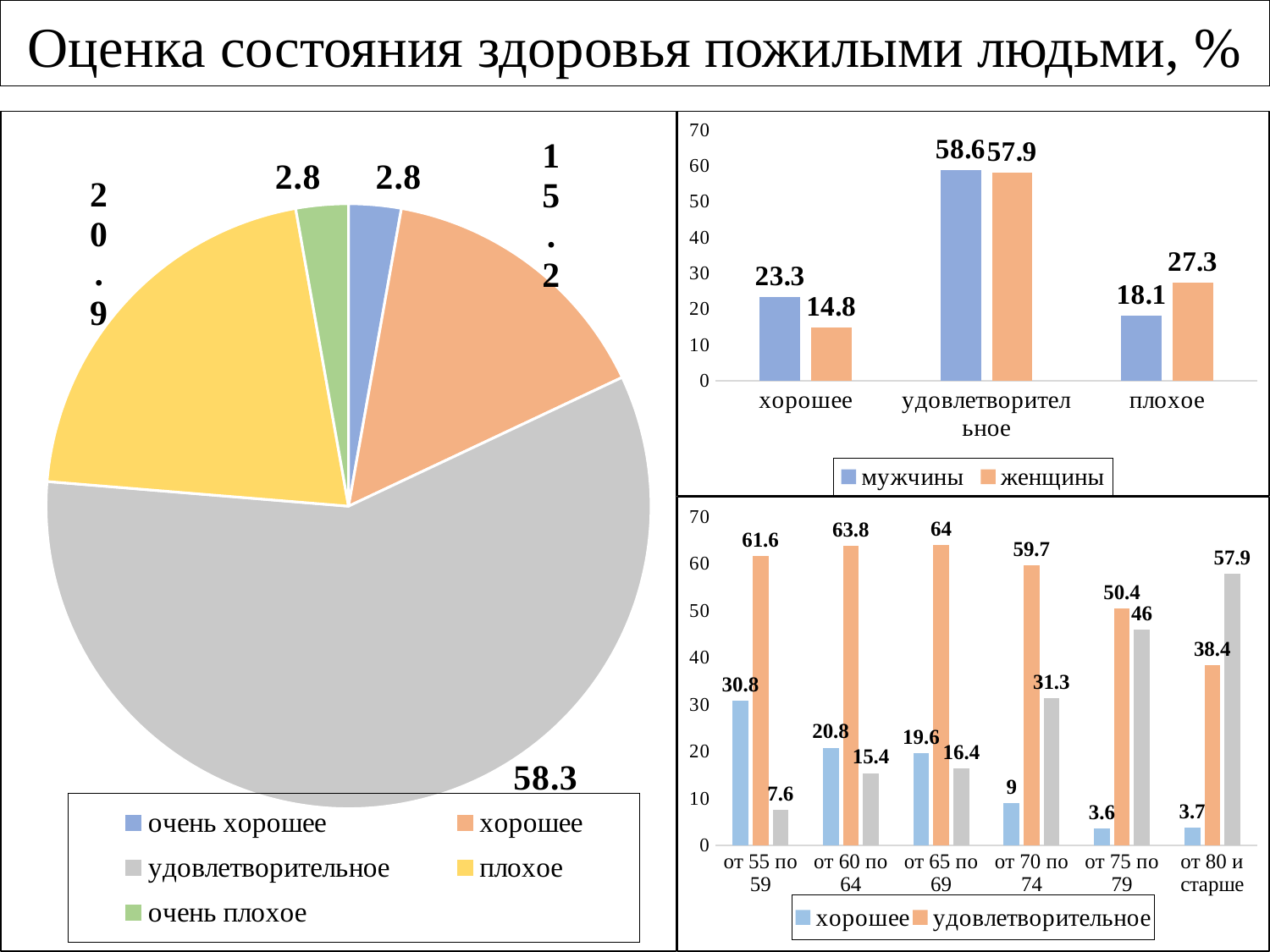
In the pie chart on the left, which category has the largest slice? удовлетворительное In the bottom-right bar chart, which age group has the highest value for удовлетворительное? от 65 по 69 In the top-right bar chart, which is larger in the удовлетворительное category: мужчины or женщины? мужчины In the top-right bar chart, what is the difference between мужчины and женщины in the хорошее category? 8.5 In the pie chart on the left, what share is labelled for удовлетворительное? 58.3 How many categories does the legend of the pie chart on the left list? 5 In the bottom-right bar chart, what is the value for хорошее in the от 70 по 74 age group? 9 In the top-right bar chart, what is the value for женщины in the плохое category? 27.3 How many series does the legend of the top-right bar chart list? 2 What type of chart is shown in the top-right of the slide? bar chart In the bottom-right bar chart, do the values for хорошее rise or fall across the age groups from left to right? fall In the pie chart on the left, what value is shown for плохое? 20.9